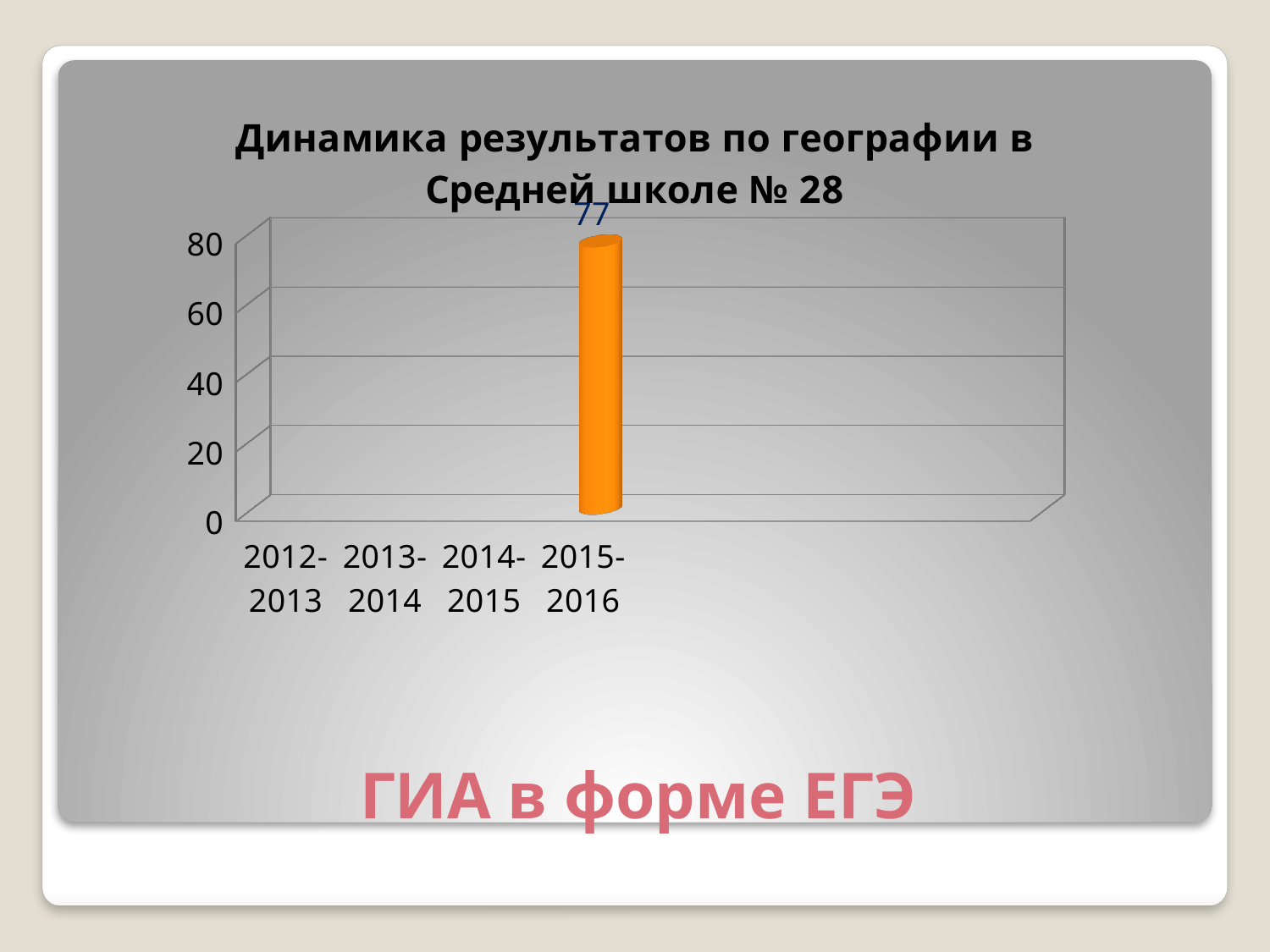
How many bars are actually plotted on the chart? 1 What kind of chart is shown on the slide? bar chart What is the value shown for 2015-2016? 77 Which category is the last one on the x axis? 2015-2016 Which category has the highest value? 2015-2016 What is the highest tick value shown on the vertical axis? 80 What is the title of the chart? Динамика результатов по географии в Средней школе № 28 Is the value for 2015-2016 greater or less than 80? less How many categories are listed on the x axis? 4 Is the value for 2015-2016 greater or less than 60? greater